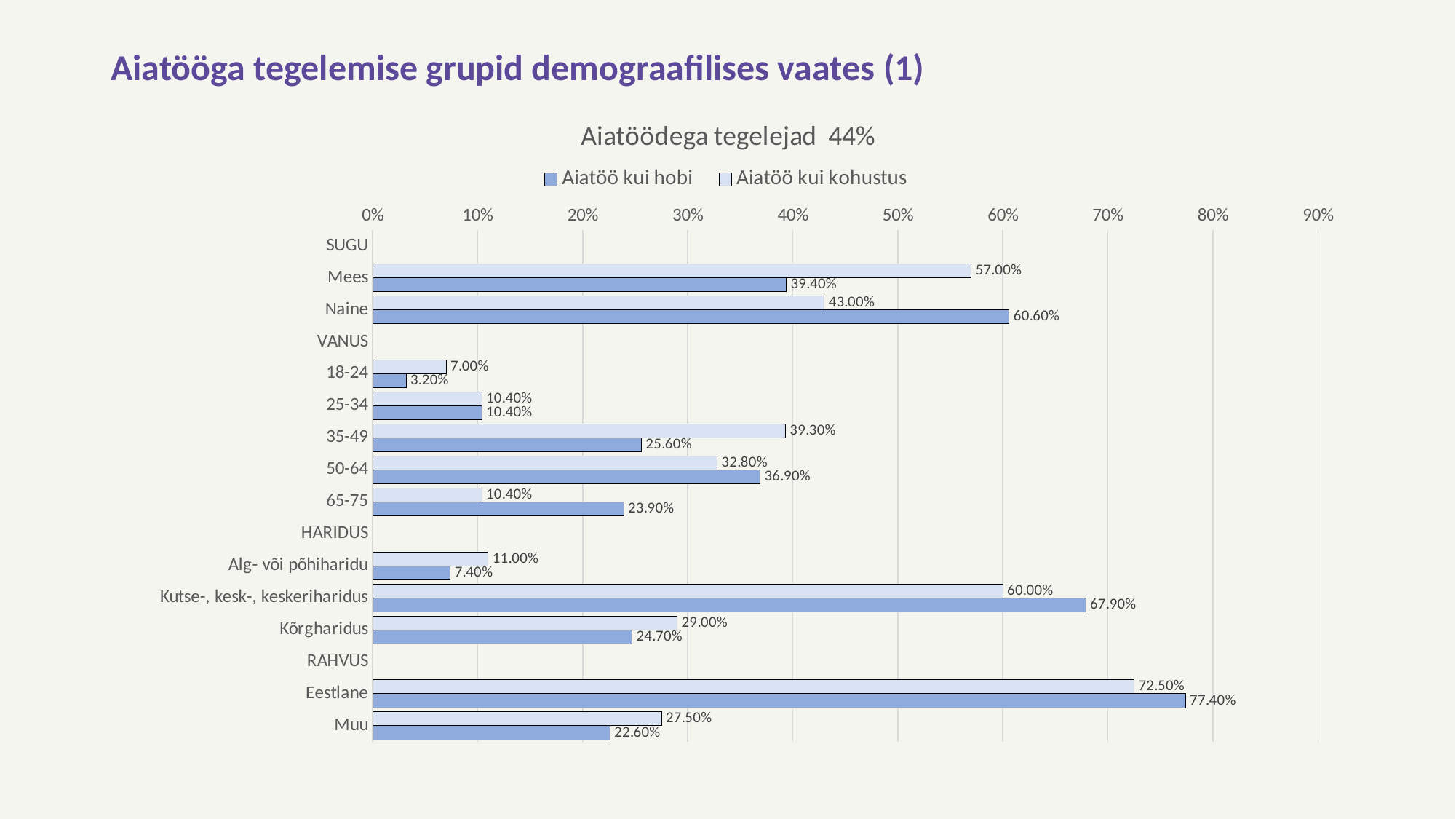
What is the title of the chart? Aiatöödega tegelejad 44% For the 50-64 age group, which is larger: "Aiatöö kui hobi" or "Aiatöö kui kohustus"? Aiatöö kui hobi What is the value of "Aiatöö kui hobi" for Naine? 60.60% What is the value of "Aiatöö kui kohustus" for Mees? 57.00% What is the difference between the "Aiatöö kui kohustus" and "Aiatöö kui hobi" values for Mees? 17.60% What is the value of "Aiatöö kui hobi" for the 65-75 age group? 23.90% How many series does the legend list? 2 Is the "Aiatöö kui hobi" value for Kutse-, kesk-, keskeriharidus greater or less than 60%? greater What kind of chart is shown on the slide? bar chart What is the value of "Aiatöö kui kohustus" for Muu? 27.50% Which category has the highest value for "Aiatöö kui hobi"? Eestlane Which category has the lowest value for "Aiatöö kui hobi"? 18-24